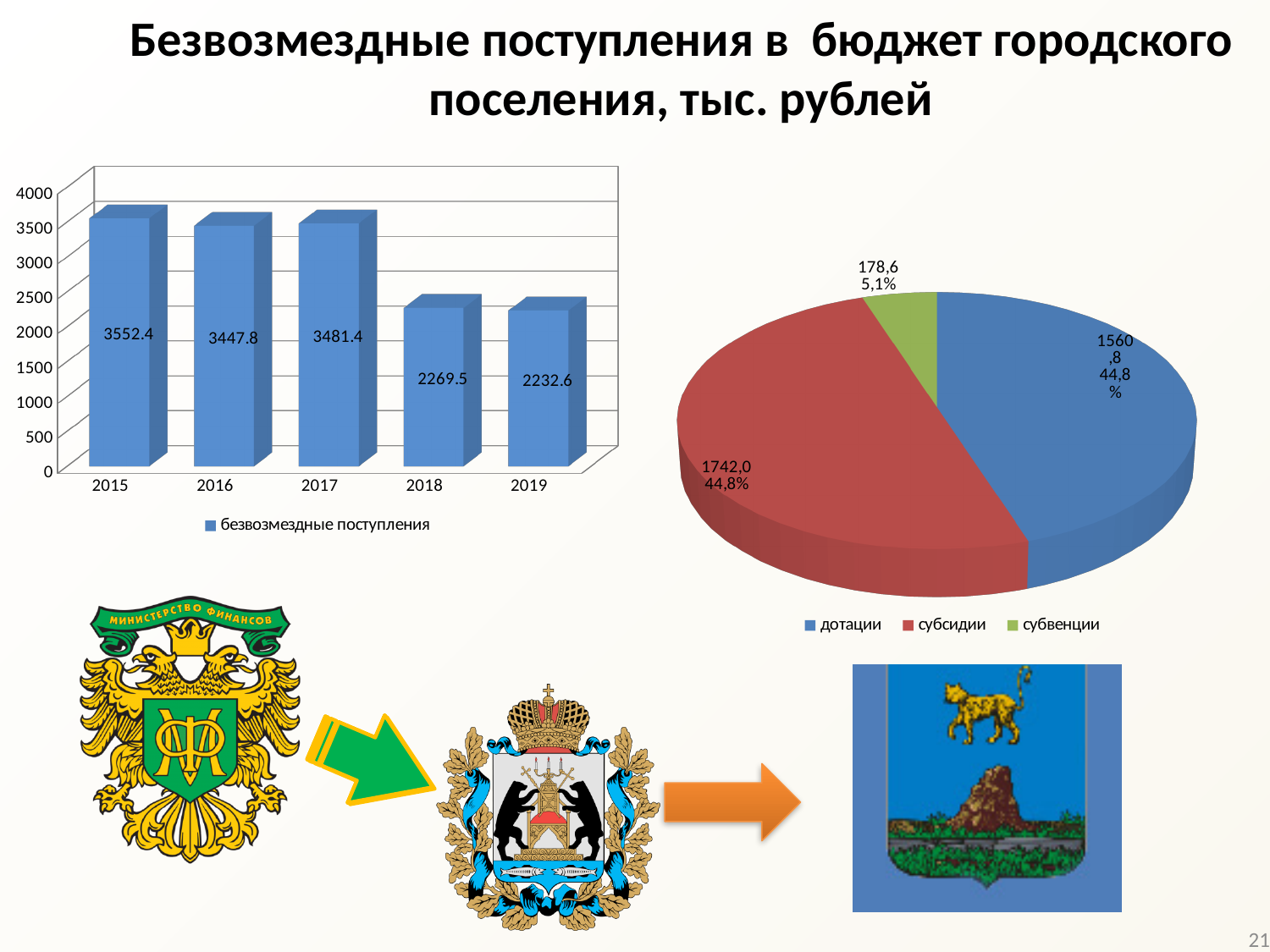
On the bar chart on the left, how many years are shown on the x axis? 5 What kind of chart is shown on the left of the slide? bar chart On the bar chart on the left, what is the value for 2015? 3552.4 On the bar chart on the left, do the values generally rise or fall from 2015 to 2019? fall On the bar chart on the left, which year has the highest value? 2015 On the bar chart on the left, what is the difference between the values for 2017 and 2018? 1211.9 On the bar chart on the left, which is larger, the value for 2016 or the value for 2017? 2017 On the bar chart on the left, which year has the lowest value? 2019 On the pie chart on the right, what value is shown for субвенции? 178,6 On the pie chart on the right, what share of the pie is субвенции? 5,1% On the bar chart on the left, what is the value for 2018? 2269.5 How many series does the legend of the pie chart on the right list? 3